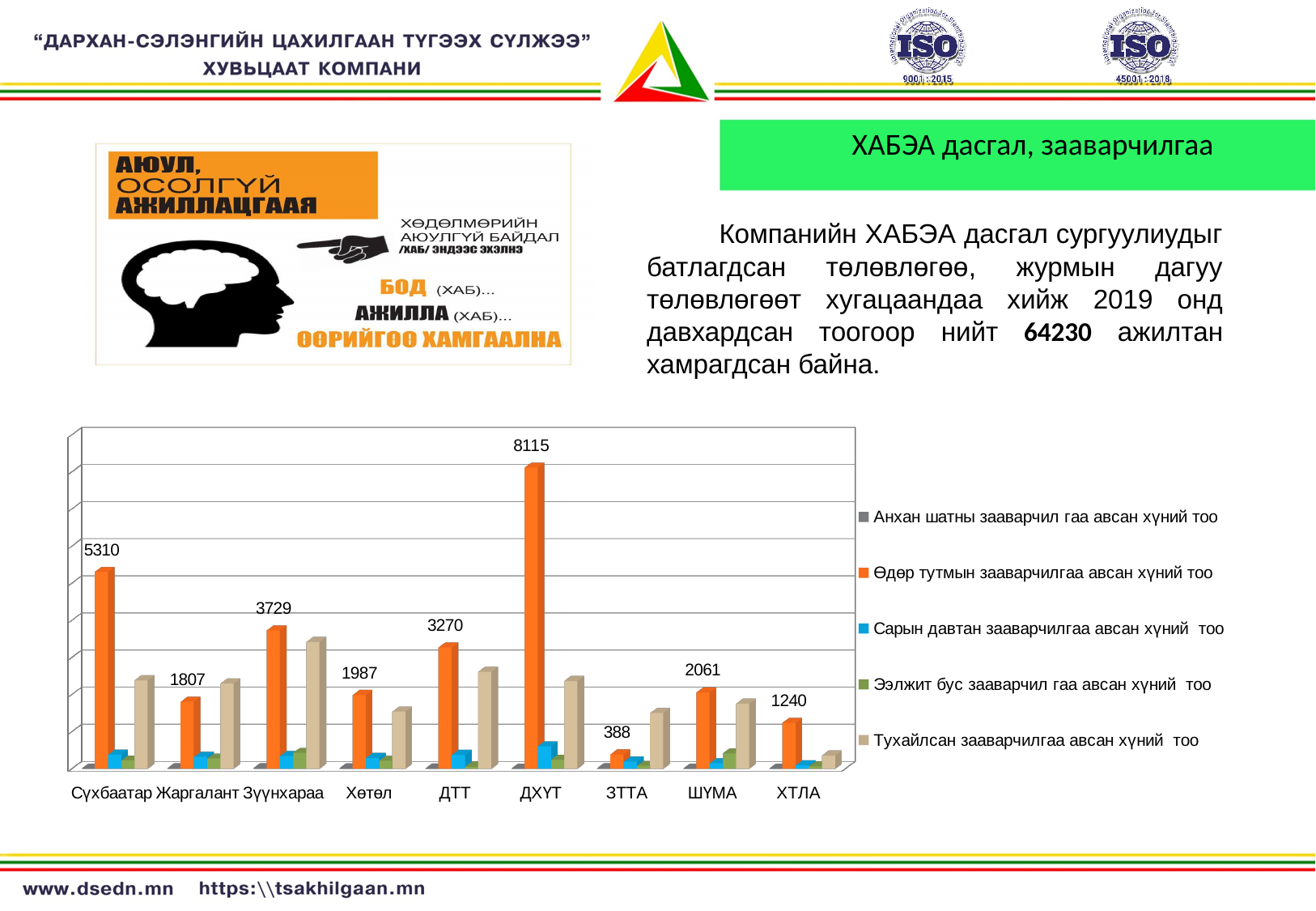
What is the value of the Өдөр тутмын заавaрчилгаа авсан хүний тоо series for ДХҮТ? 8115 What kind of chart is shown on the slide? Bar chart Which series is shown in orange in the chart legend? Өдөр тутмын заавaрчилгаа авсан хүний тоо How many series does the chart legend list? 5 How many categories are shown on the x axis of the chart? 9 Which category has the highest value for the Өдөр тутмын заавaрчилгаа авсан хүний тоо series? ДХҮТ Which has a larger Өдөр тутмын заавaрчилгаа авсан хүний тоо value, Хөтөл or ДТТ? ДТТ Which category has the lowest value for the Өдөр тутмын заавaрчилгаа авсан хүний тоо series? ЗТТА What is the value of the Өдөр тутмын заавaрчилгаа авсан хүний тоо series for Зүүнхараа? 3729 What is the value of the Өдөр тутмын заавaрчилгаа авсан хүний тоо series for ШҮМА? 2061 What is the difference between the Өдөр тутмын заавaрчилгаа авсан хүний тоо values for ДХҮТ and Сүхбаатар? 2805 What is the value of the Өдөр тутмын заавaрчилгаа авсан хүний тоо series for Сүхбаатар? 5310